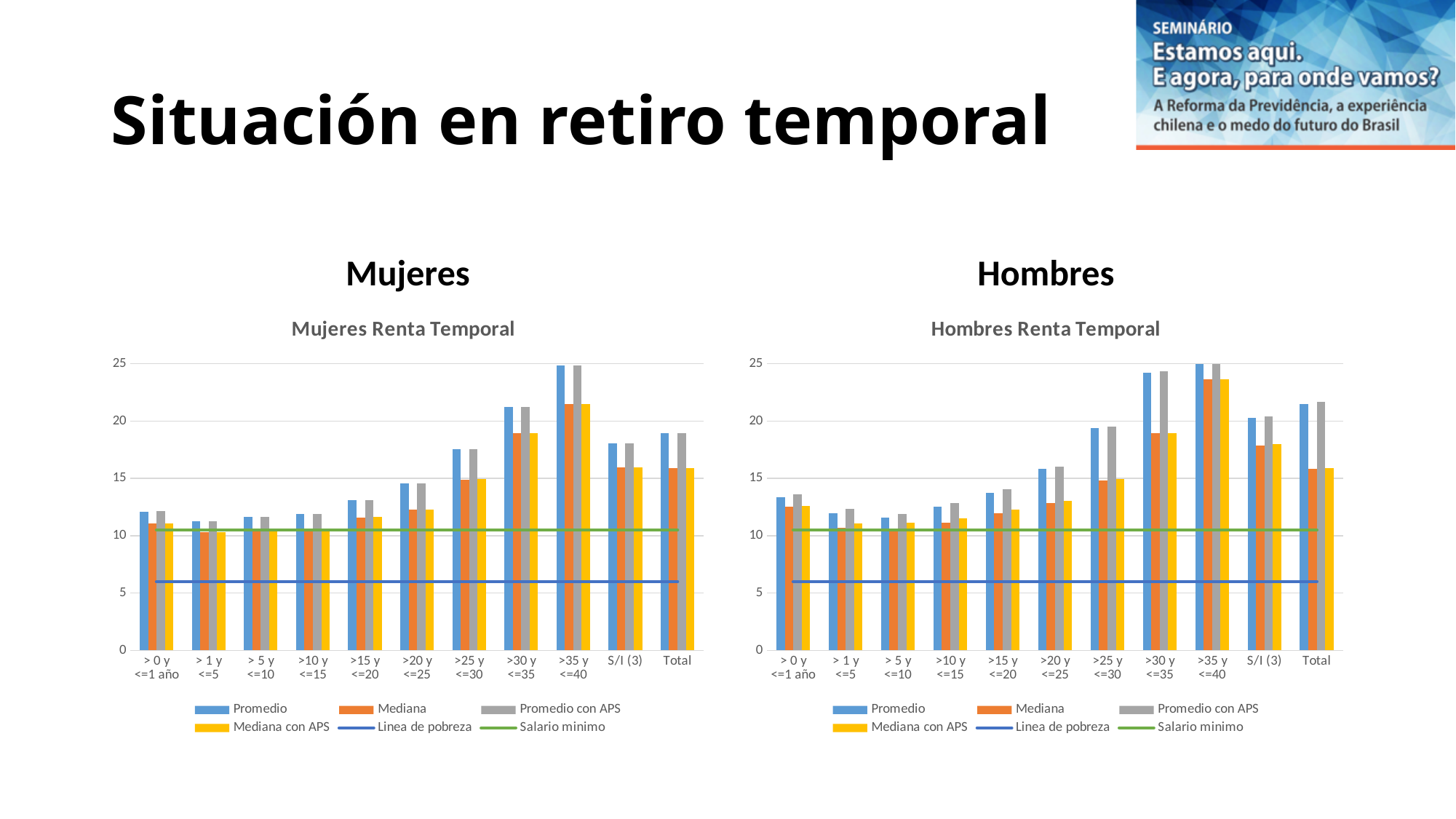
What kind of chart is the Mujeres Renta Temporal chart? bar chart In the Hombres Renta Temporal chart, is the Mediana value for >1 y <=5 greater or less than 15? less In the Hombres Renta Temporal chart, is the Promedio value for >30 y <=35 greater or less than 20? greater What is the title of the chart on the right side of the slide? Hombres Renta Temporal In the Hombres Renta Temporal chart, do the Promedio values generally rise or fall from >5 y <=10 to >35 y <=40? rise In the Mujeres Renta Temporal chart, how many categories are shown on the x axis? 11 In the Mujeres Renta Temporal chart, which is larger, the Promedio value for >30 y <=35 or for >25 y <=30? >30 y <=35 In the Mujeres Renta Temporal chart, which category has the highest Promedio value? >35 y <=40 In the Hombres Renta Temporal chart, how many series does the legend list? 6 In the Hombres Renta Temporal chart, which category has the highest Promedio value? >35 y <=40 In the Mujeres Renta Temporal chart, is the Mediana value for >0 y <=1 año greater or less than 15? less